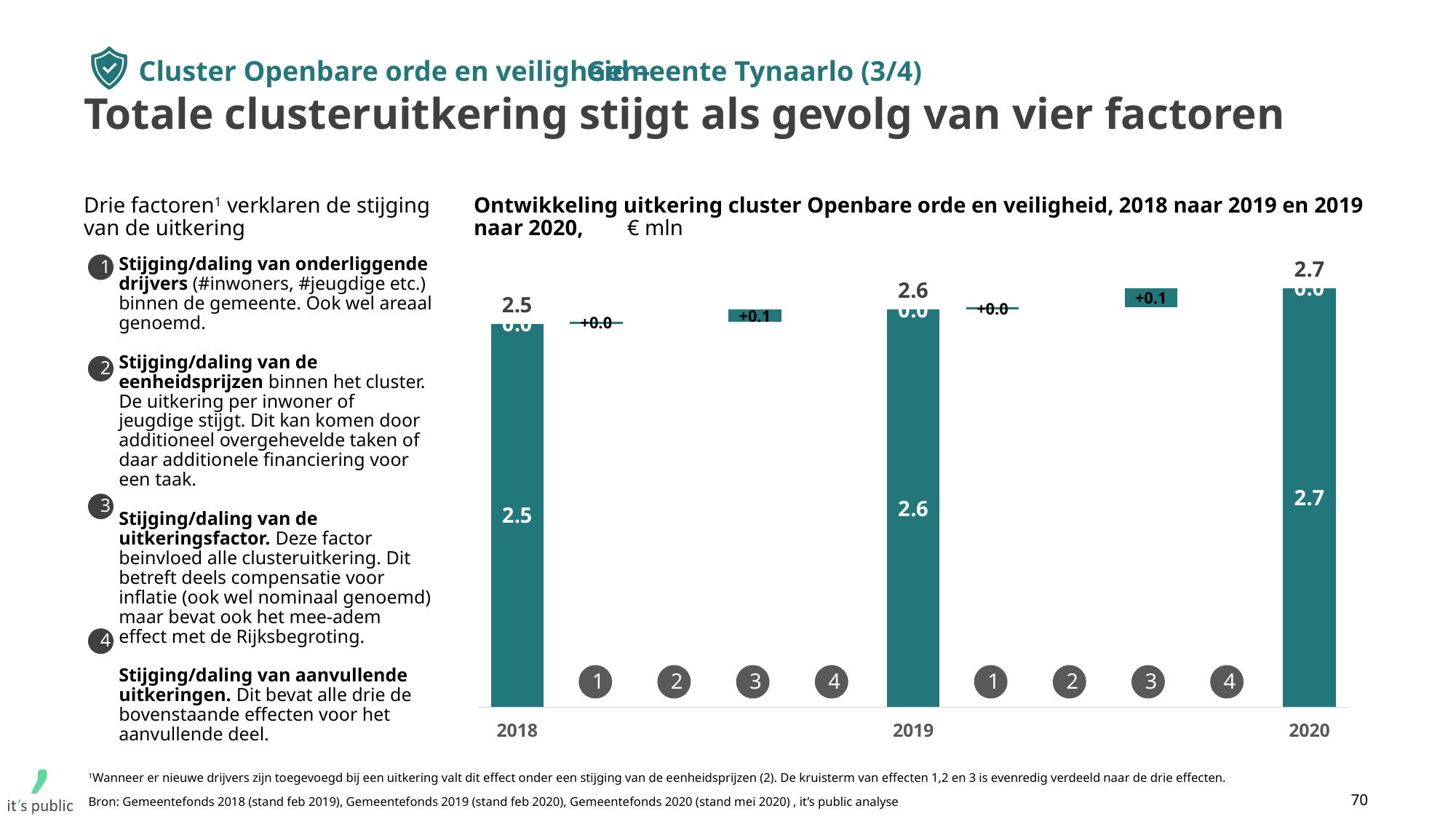
What is the difference between the 2019 total and the 2018 total? 0.1 What is the effect of factor 3 in the step from 2018 to 2019? +0.1 What is the total cluster payment shown for 2020? 2.7 What is the effect of factor 1 in the step from 2019 to 2020? +0.0 Which year has the highest total cluster payment? 2020 Which is larger, the total for 2019 or the total for 2020? 2020 What is the difference between the 2020 total and the 2018 total? 0.2 What kind of chart is shown on the slide? bar chart Which year has the lowest total cluster payment? 2018 What is the total cluster payment shown for 2019? 2.6 Do the yearly totals rise or fall from 2018 to 2020? rise What is the total cluster payment shown for 2018? 2.5